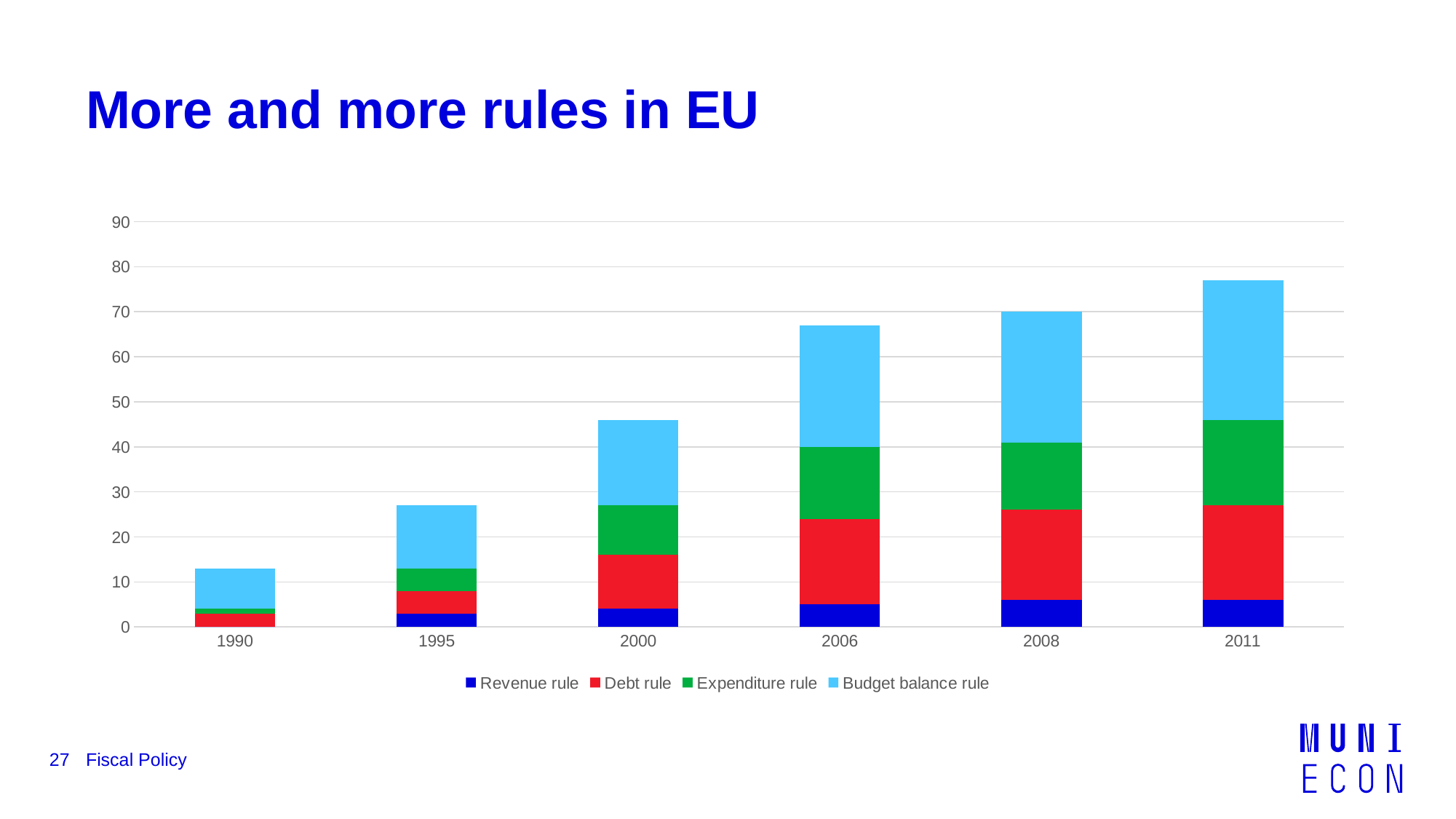
How many years are shown on the x axis of the chart? 6 Which year has the tallest stacked bar? 2011 Is the total bar height for 2000 greater or less than 50? less Which year has the shortest stacked bar? 1990 Is the total bar height for 1990 greater or less than 10? greater What kind of chart is shown on the slide? Stacked bar chart What is the title of the slide containing the chart? More and more rules in EU Which year has a taller stacked bar, 1995 or 2006? 2006 How many series does the chart's legend list? 4 Is the total bar height for 2011 greater or less than 70? greater Which series is shown in light blue in the legend? Budget balance rule Do the total bar heights rise or fall from 1990 to 2011? Rise